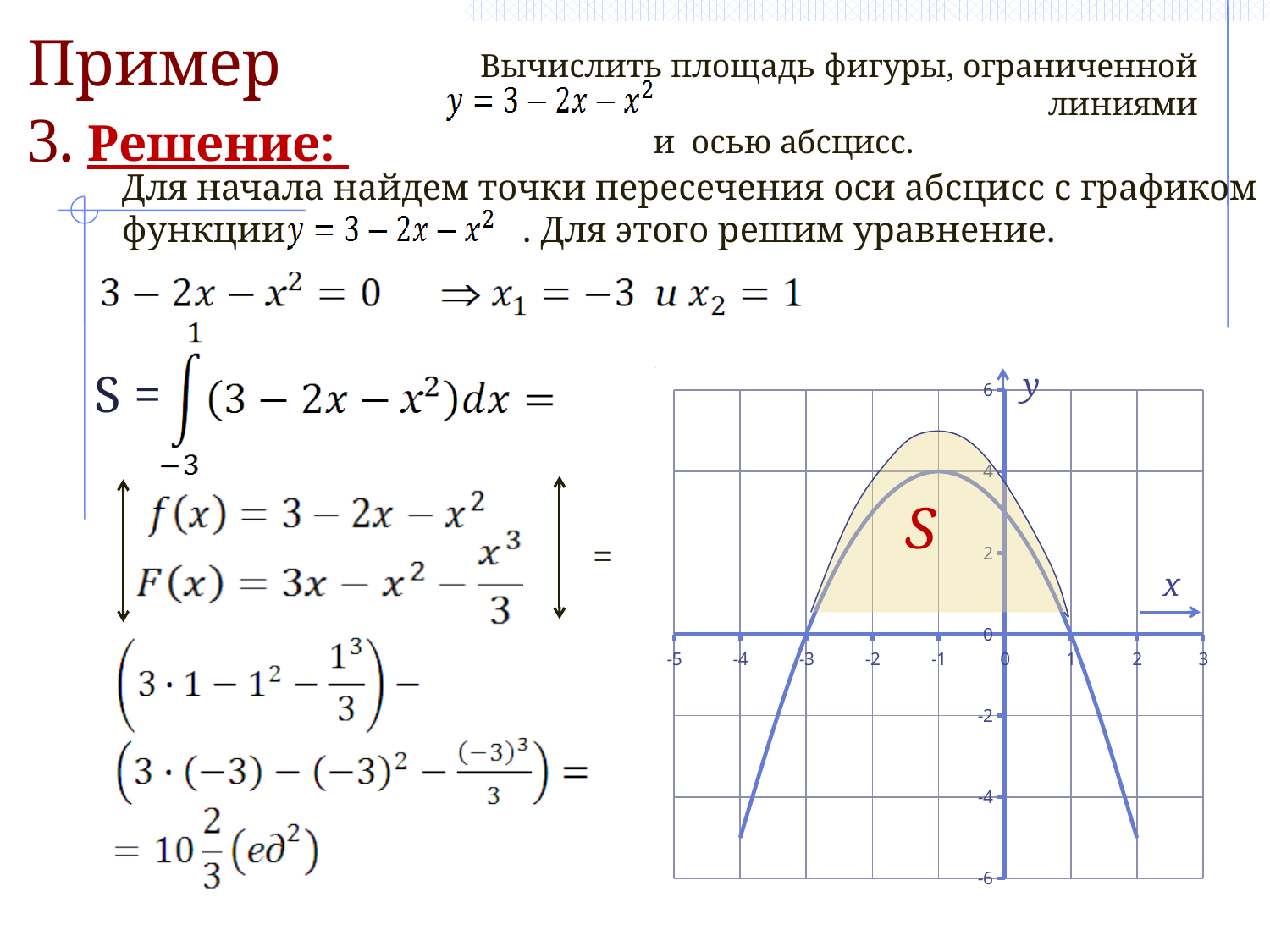
What are the lowest and highest tick values shown on the x-axis? -5 and 3 Is the value of the curve at x = 2 greater or less than -4? less Is the value of the curve at x = -4 greater or less than 0? less What kind of chart is shown on the slide? line chart (graph of a function) Does the curve rise or fall as x goes from -1 to 1? fall At which x-values does the plotted curve cross the x-axis? -3 and 1 How many times does the plotted curve cross the x-axis? 2 What is the highest y-value reached by the plotted curve? 4 Is the value of the curve at x = -1 greater or less than 2? greater Which is larger: the value of the curve at x = -1 or at x = 0? x = -1 At which x-value does the plotted curve reach its highest point? -1 What letter labels the shaded region under the curve? S